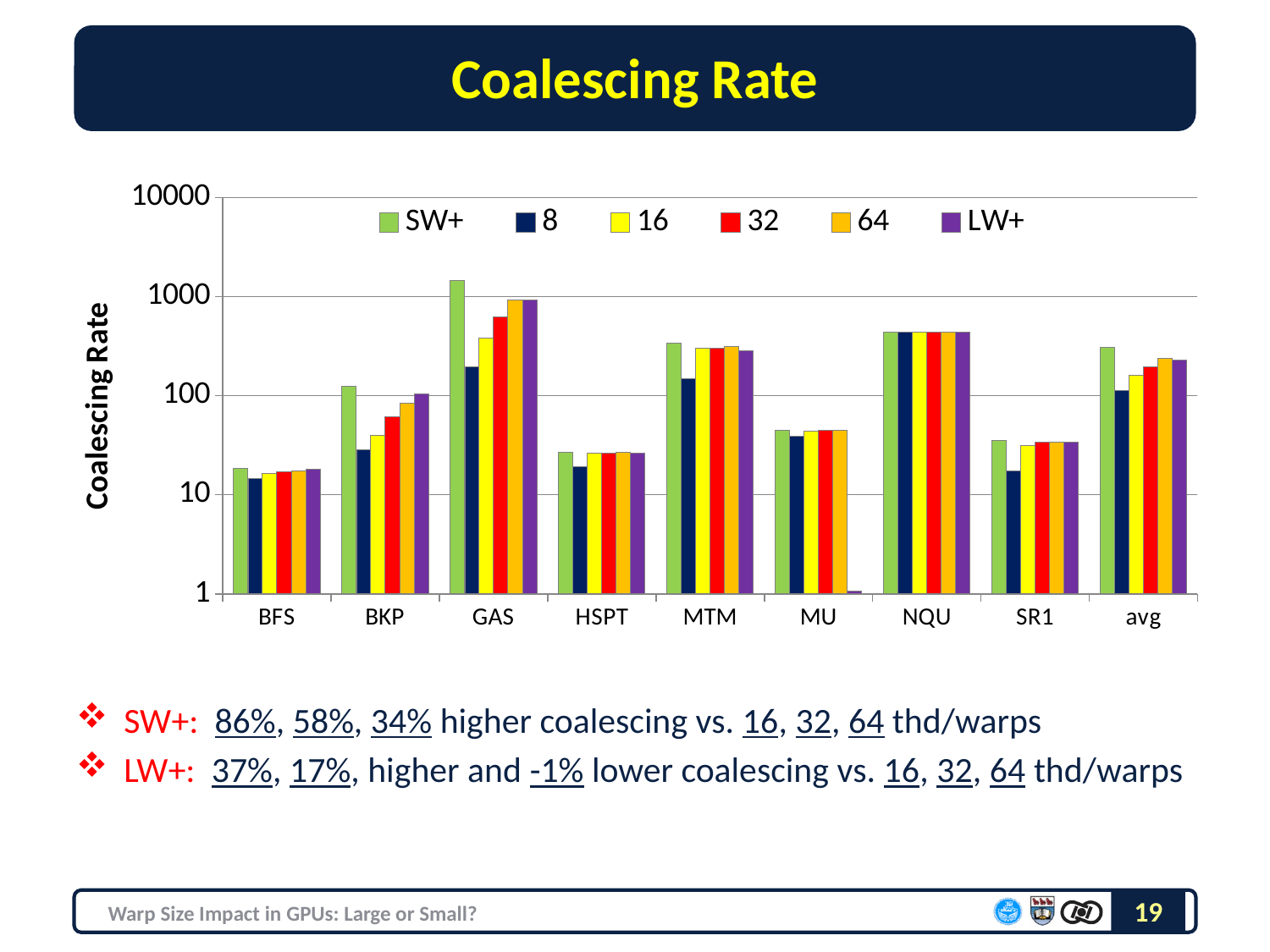
In the GAS category, which series has the lowest bar? 8 What kind of chart is shown on the slide? bar chart Which category has the lowest SW+ bar? BFS How many series does the chart's legend list? 6 What is the label of the y axis of the chart? Coalescing Rate In the BKP category, which is larger: the 8 bar or the LW+ bar? LW+ In the MU category, which series has the lowest bar? LW+ Is the LW+ value for MU greater or less than 10? less How many categories are shown along the x axis of the chart? 9 Which category has the highest SW+ bar? GAS Is the SW+ value for avg greater or less than 100? greater Is the SW+ value for GAS greater or less than 1000? greater